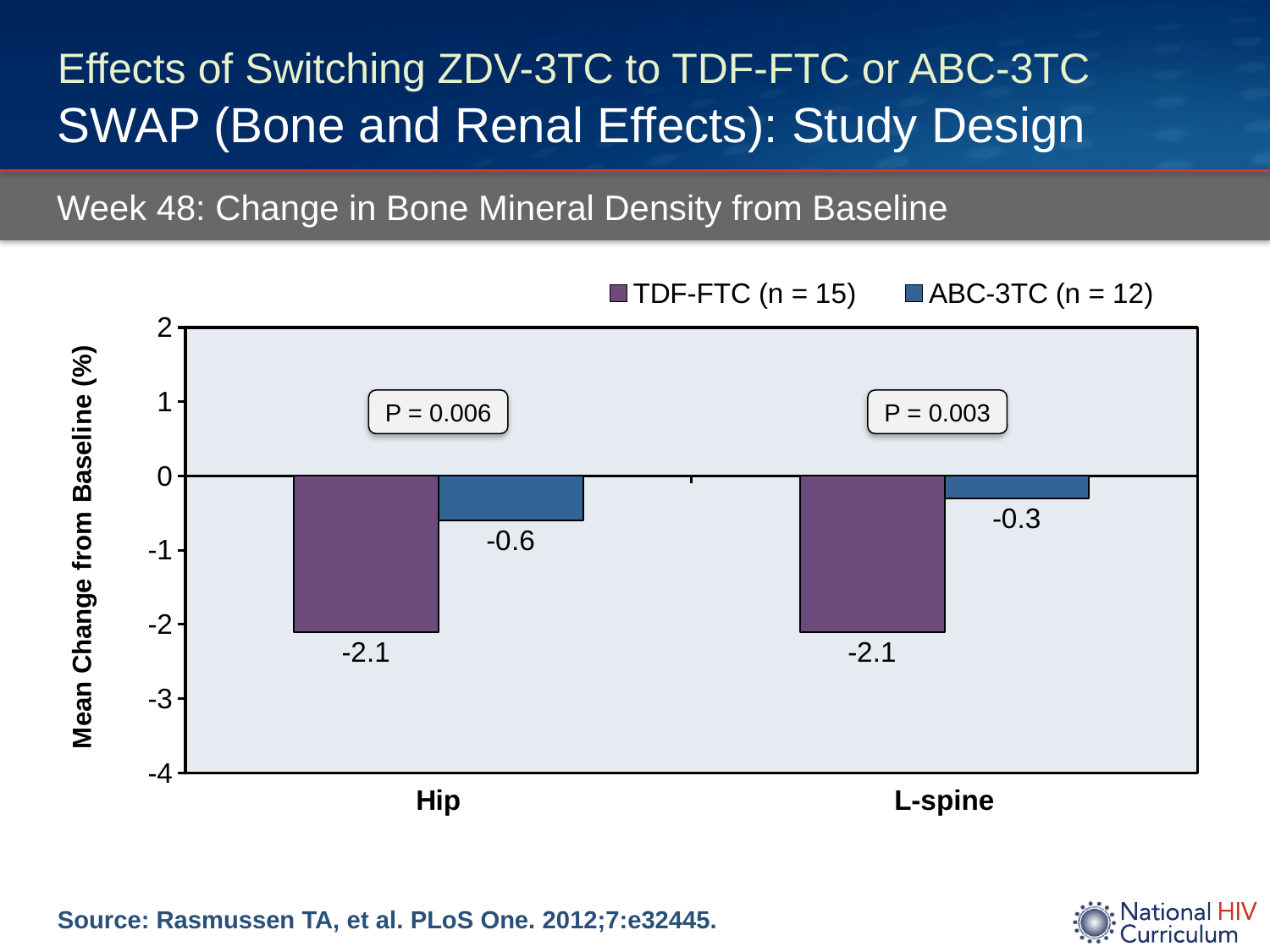
Which bar shows the smallest decrease from baseline across the chart? ABC-3TC at L-spine Which series shows the larger decrease in bone mineral density at the L-spine? TDF-FTC How many categories are shown on the x axis? 2 What is the mean change from baseline for ABC-3TC at the Hip? -0.6 What is the mean change from baseline for TDF-FTC at the L-spine? -2.1 What P value is shown for the Hip comparison? P = 0.006 What is the difference between the TDF-FTC and ABC-3TC values at the Hip? 1.5 What kind of chart is shown on the slide? Bar chart What is the difference between the TDF-FTC and ABC-3TC values at the L-spine? 1.8 How many series does the legend list? 2 What is the mean change from baseline for ABC-3TC at the L-spine? -0.3 What is the mean change from baseline for TDF-FTC at the Hip? -2.1